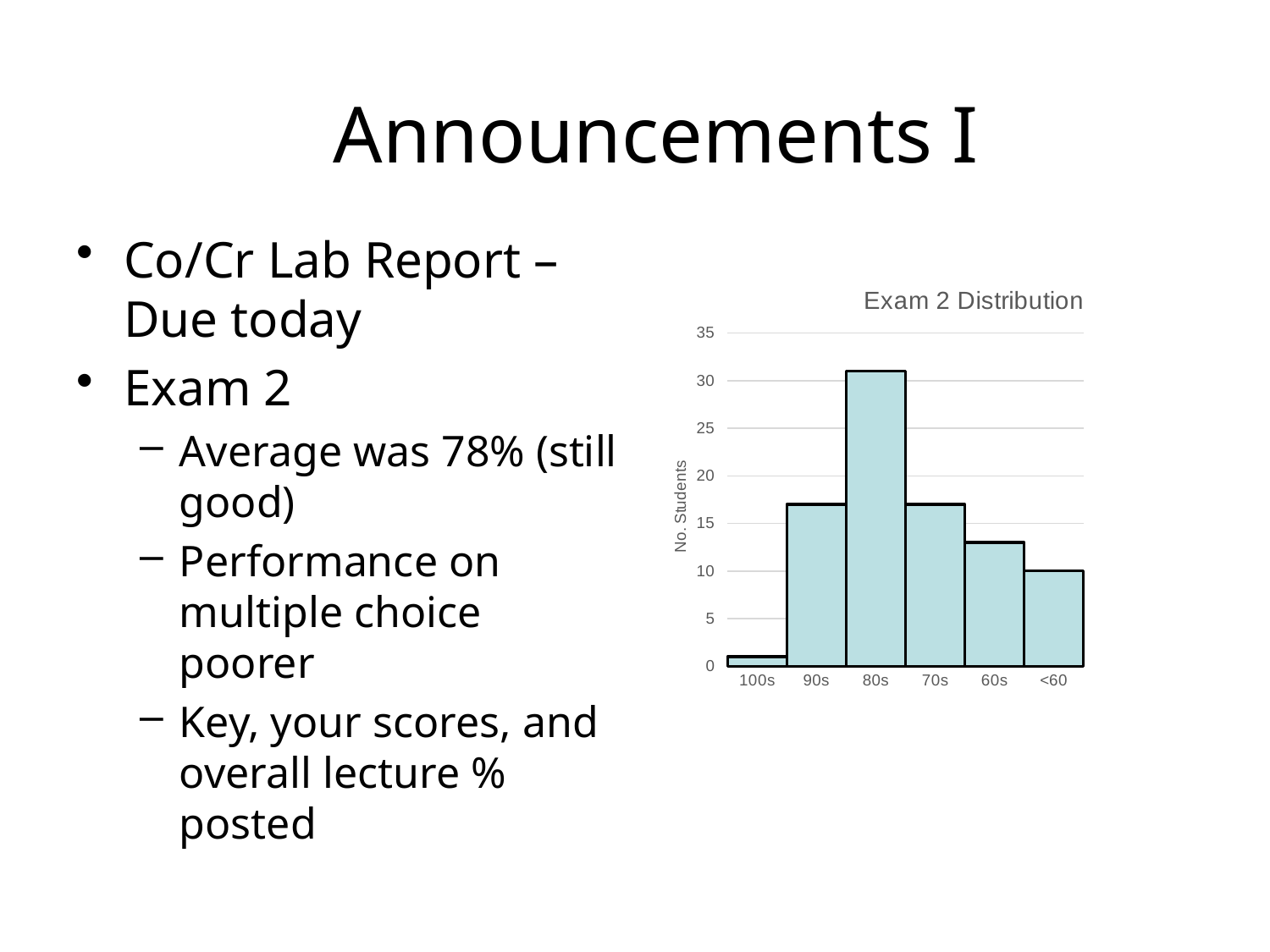
In the Exam 2 Distribution chart, which category has more students, 60s or <60? 60s How many score categories are shown on the x axis of the Exam 2 Distribution chart? 6 Which score category has the highest number of students in the Exam 2 Distribution chart? 80s Which score category has the lowest number of students in the Exam 2 Distribution chart? 100s In the Exam 2 Distribution chart, is the number of students in the 80s greater or less than 30? greater In the Exam 2 Distribution chart, which category has more students, 80s or 90s? 80s What is the label on the vertical axis of the Exam 2 Distribution chart? No. Students In the Exam 2 Distribution chart, how many students scored below 60 (the <60 category)? 10 In the Exam 2 Distribution chart, is the number of students in the 60s greater or less than 15? less What is the title of the chart on the slide? Exam 2 Distribution In the Exam 2 Distribution chart, is the number of students in the 90s greater or less than 20? less What kind of chart is the Exam 2 Distribution chart? bar chart